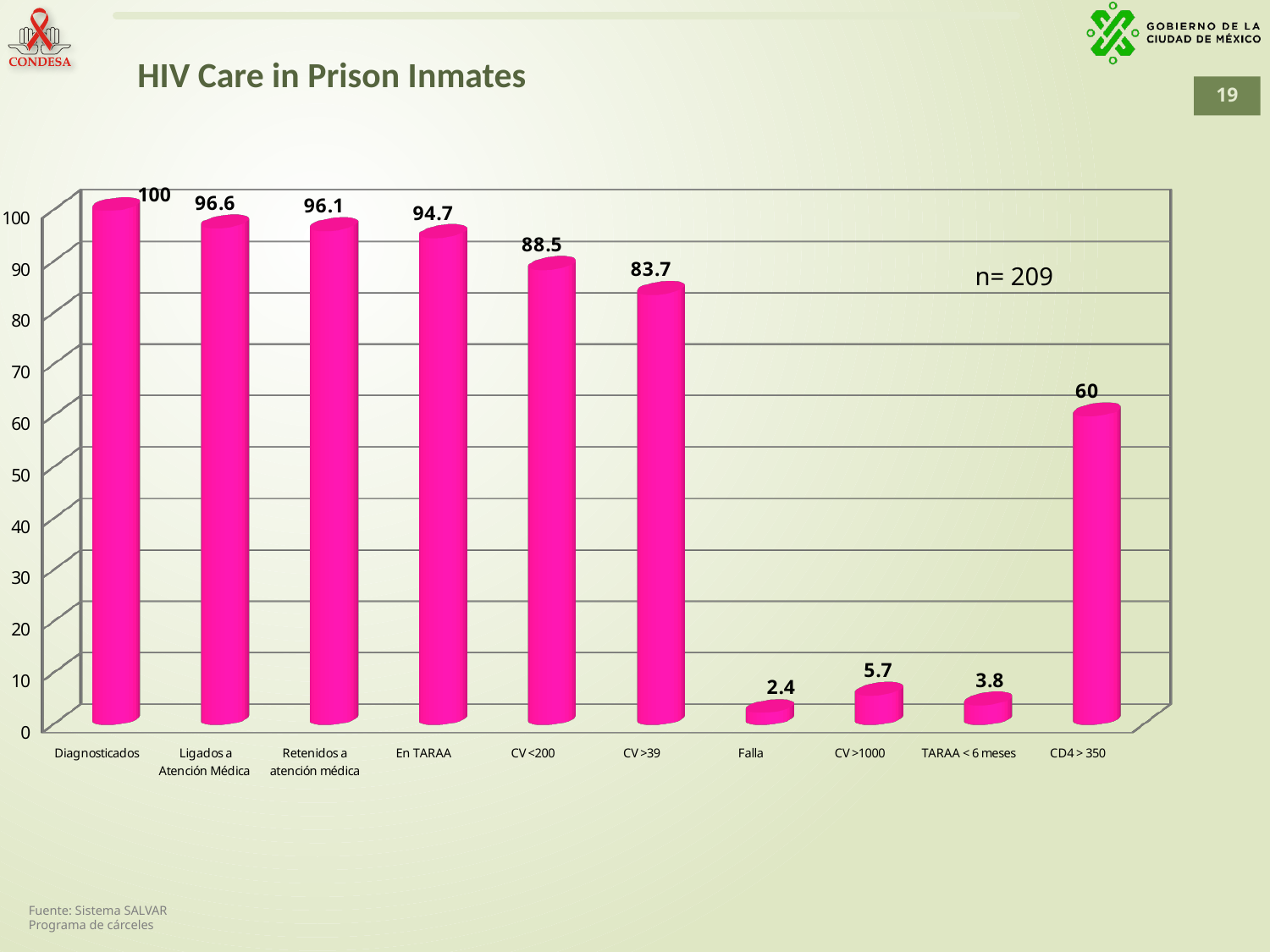
Which category has the highest value? Diagnosticados What kind of chart is shown on the slide? bar chart What is the value for Diagnosticados? 100 What is the difference between the values for En TARAA and CV >39? 11 What is the value for Ligados a Atención Médica? 96.6 Which is larger, the value for CV >1000 or the value for TARAA < 6 meses? CV >1000 What is the value for CV <200? 88.5 How many categories are shown on the x axis? 10 What is the value for CD4 > 350? 60 Which category has the lowest value? Falla What sample size (n) is stated on the chart? n= 209 What is the value for TARAA < 6 meses? 3.8